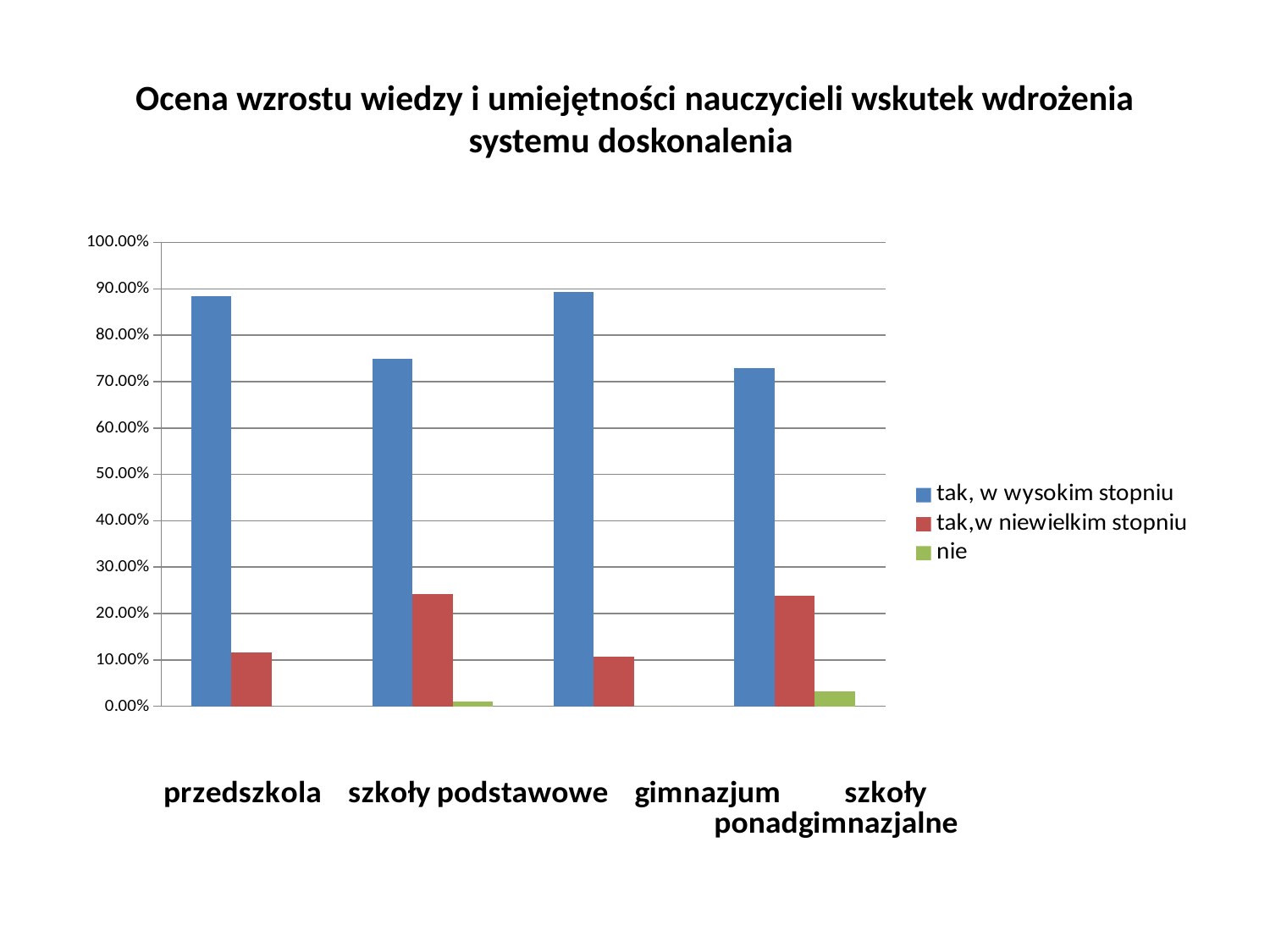
Which is larger for 'tak,w niewielkim stopniu': przedszkola or szkoły podstawowe? szkoły podstawowe What kind of chart is shown on the slide? bar chart Is the value for 'tak, w wysokim stopniu' for szkoły podstawowe greater or less than 80.00%? less Is the value for 'tak, w wysokim stopniu' for przedszkola greater or less than 80.00%? greater Is the value for 'tak,w niewielkim stopniu' for szkoły podstawowe greater or less than 20.00%? greater Which series is shown in green in the legend? nie Which category has the highest value for the 'nie' series? szkoły ponadgimnazjalne Which is larger for 'tak, w wysokim stopniu': przedszkola or szkoły podstawowe? przedszkola How many series does the legend list? 3 What is the title of the chart? Ocena wzrostu wiedzy i umiejętności nauczycieli wskutek wdrożenia systemu doskonalenia How many categories are shown on the x axis? 4